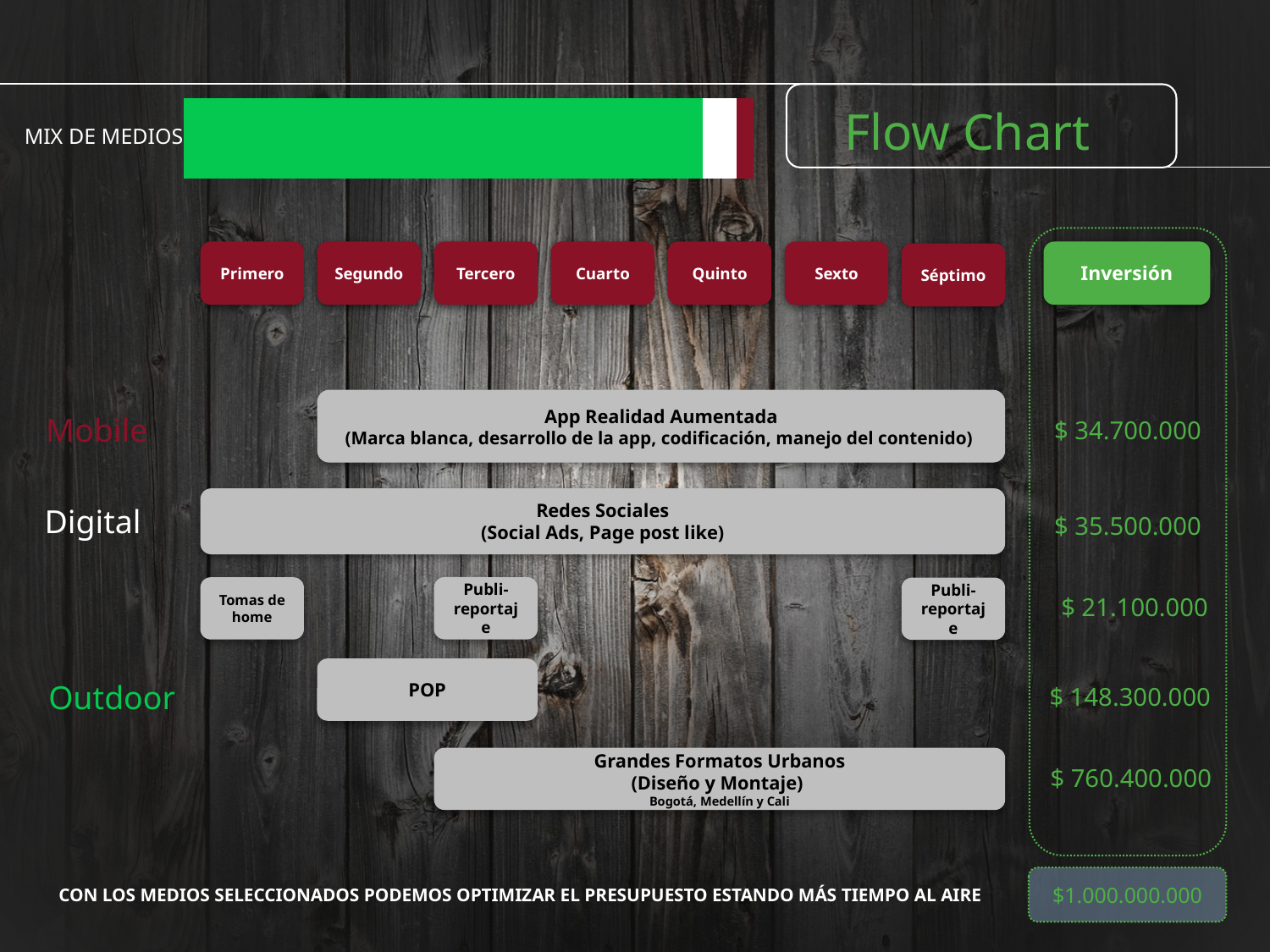
What is the investment shown for the row with Tomas de home and Publi-reportaje? $ 21.100.000 Which has a larger investment, POP or Redes Sociales? POP What is the investment shown for Redes Sociales (Social Ads, Page post like)? $ 35.500.000 How many time periods (Primero to Séptimo) are shown across the top of the flow chart? 7 What are the three media categories listed on the left side of the flow chart? Mobile, Digital, Outdoor What is the investment shown for POP? $ 148.300.000 Which item has the highest investment in the flow chart? Grandes Formatos Urbanos What is the difference between the investment for Redes Sociales and the investment for App Realidad Aumentada? $ 800.000 What is the investment shown for Grandes Formatos Urbanos (Diseño y Montaje)? $ 760.400.000 Which item has the lowest investment in the flow chart? Tomas de home / Publi-reportaje What is the total investment shown at the bottom of the Inversión column? $1.000.000.000 What is the investment (Inversión) shown for App Realidad Aumentada? $ 34.700.000